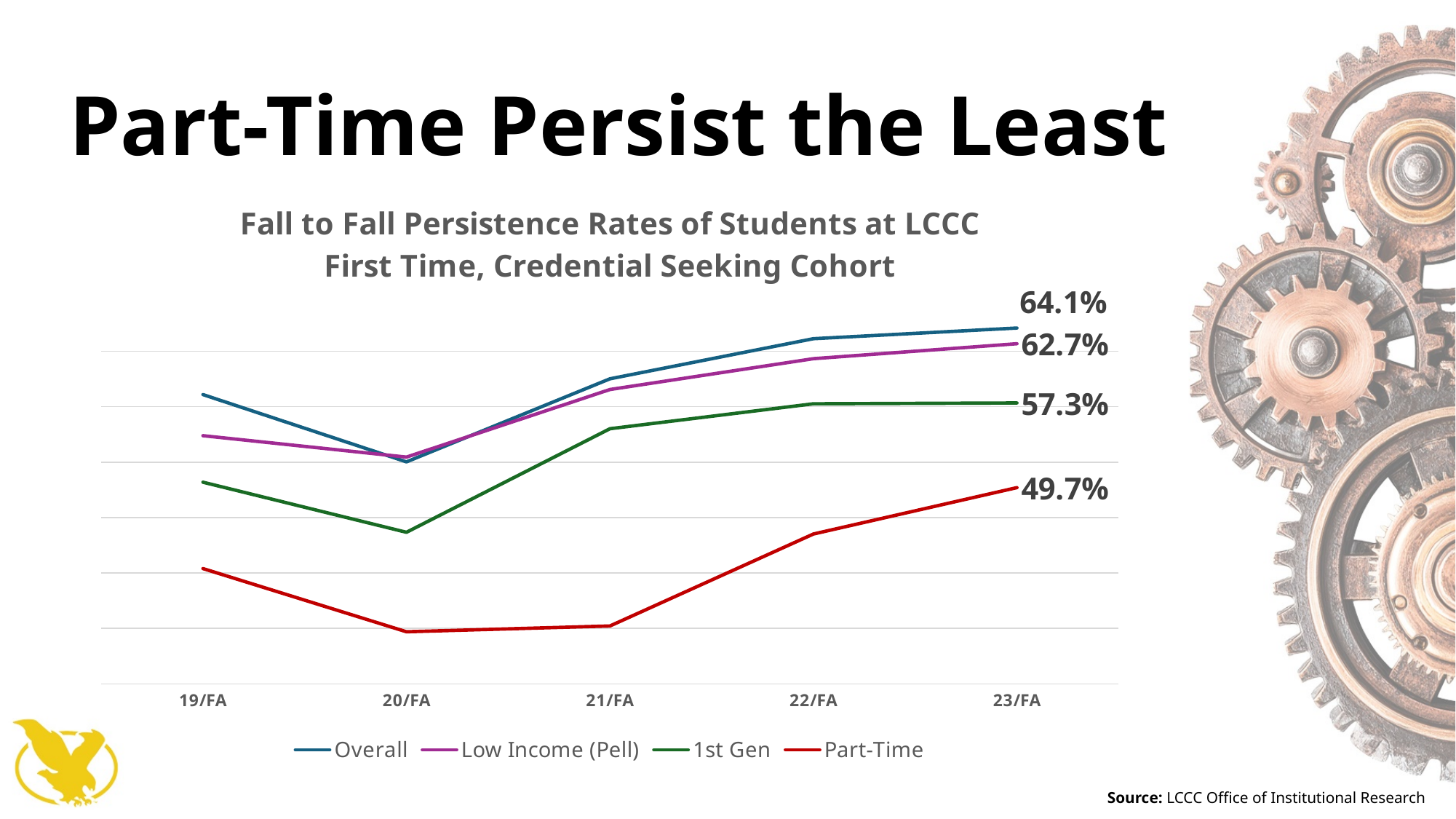
What type of chart is shown on the slide? line chart What is the Low Income (Pell) persistence rate at 23/FA? 62.7% Does the Part-Time persistence rate rise or fall from 21/FA to 23/FA? rise Which series has the lowest persistence rate at 23/FA? Part-Time How many cohort terms are shown on the x axis? 5 What is the difference between the Low Income (Pell) and 1st Gen persistence rates at 23/FA? 5.4% What is the 1st Gen persistence rate at 23/FA? 57.3% How many series does the legend list? 4 Which series has the highest persistence rate at 23/FA? Overall What is the Part-Time persistence rate at 23/FA? 49.7% What is the difference between the Overall and Part-Time persistence rates at 23/FA? 14.4% What is the Overall persistence rate at 23/FA? 64.1%